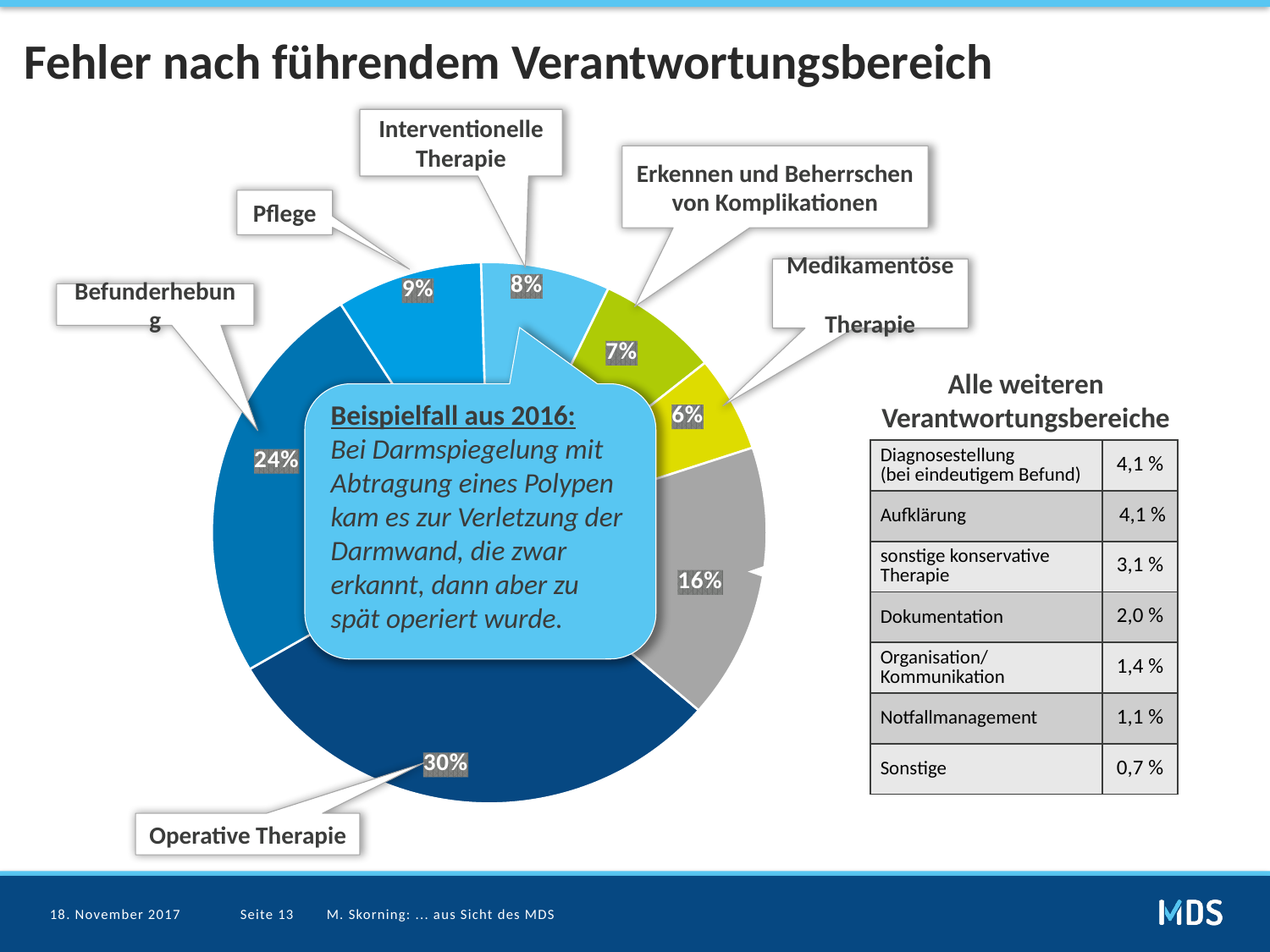
What share of the pie does Medikamentöse Therapie have? 6% What share of the pie does Interventionelle Therapie have? 8% What is the difference in percentage points between Operative Therapie and Befunderhebung? 6 Which category has the largest slice of the pie? Operative Therapie Which of the labelled categories has the smallest slice of the pie? Medikamentöse Therapie What share of the pie does Pflege have? 9% What is the chart's title? Fehler nach führendem Verantwortungsbereich Which is larger, the slice for Pflege or the slice for Interventionelle Therapie? Pflege What share of the pie does Operative Therapie have? 30% What share of the pie does Erkennen und Beherrschen von Komplikationen have? 7% What kind of chart is shown on the slide? pie chart What share of the pie does Befunderhebung have? 24%